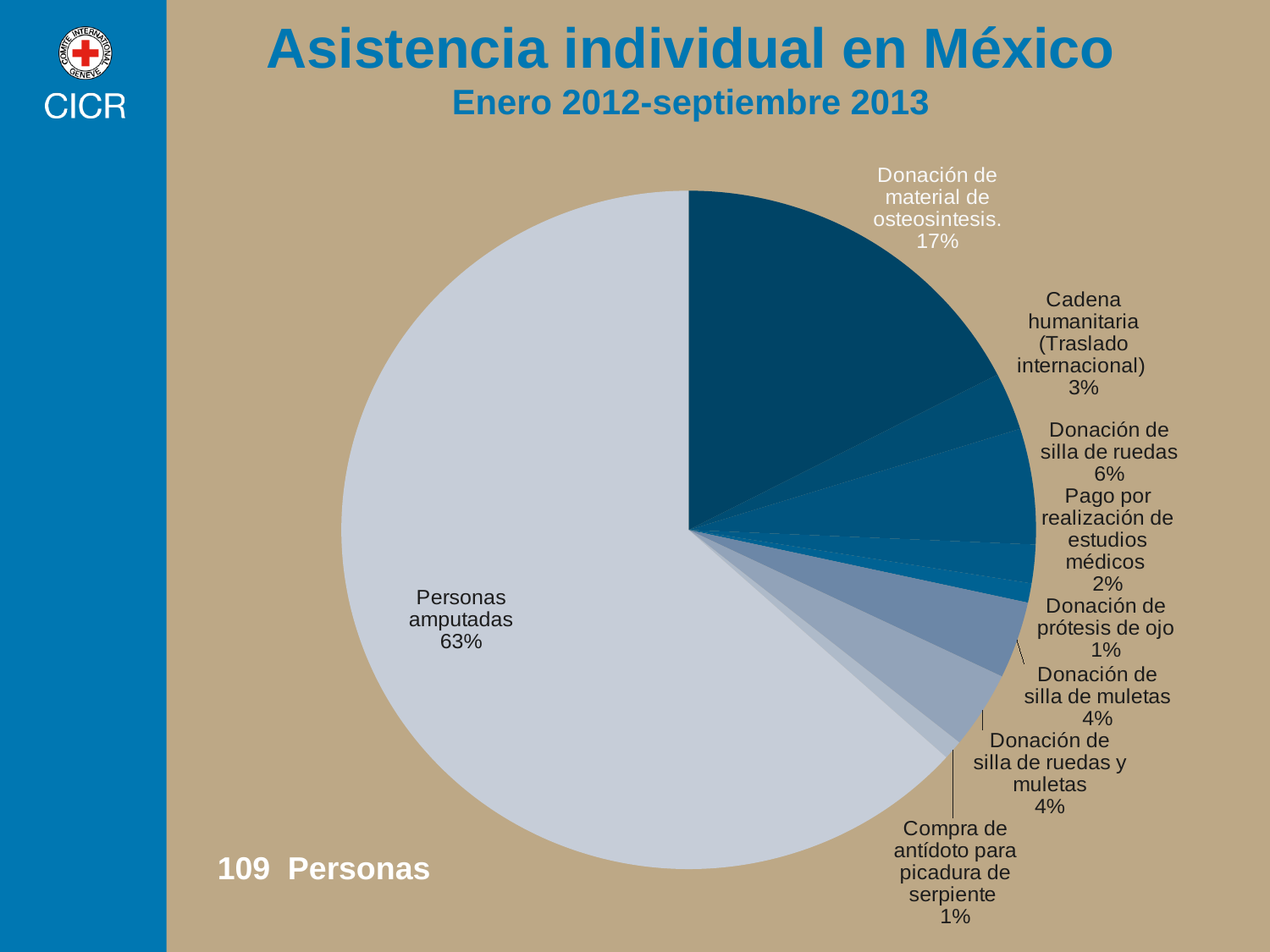
What share of the pie does "Personas amputadas" represent? 63% What kind of chart is shown on the slide? pie chart What percentage is shown for "Donación de material de osteosintesis"? 17% What is the difference in percentage points between "Personas amputadas" and "Donación de material de osteosintesis"? 46 What is the title of the chart on the slide? Asistencia individual en México What percentage is shown for "Donación de silla de ruedas"? 6% How many people in total does the slide say were assisted? 109 Personas Which category has the largest share of the pie? Personas amputadas How many categories (slices) does the pie chart have? 9 Which is larger, the share for "Donación de silla de ruedas" or the share for "Donación de silla de muletas"? Donación de silla de ruedas What percentage is shown for "Cadena humanitaria (Traslado internacional)"? 3% What percentage is shown for "Pago por realización de estudios médicos"? 2%